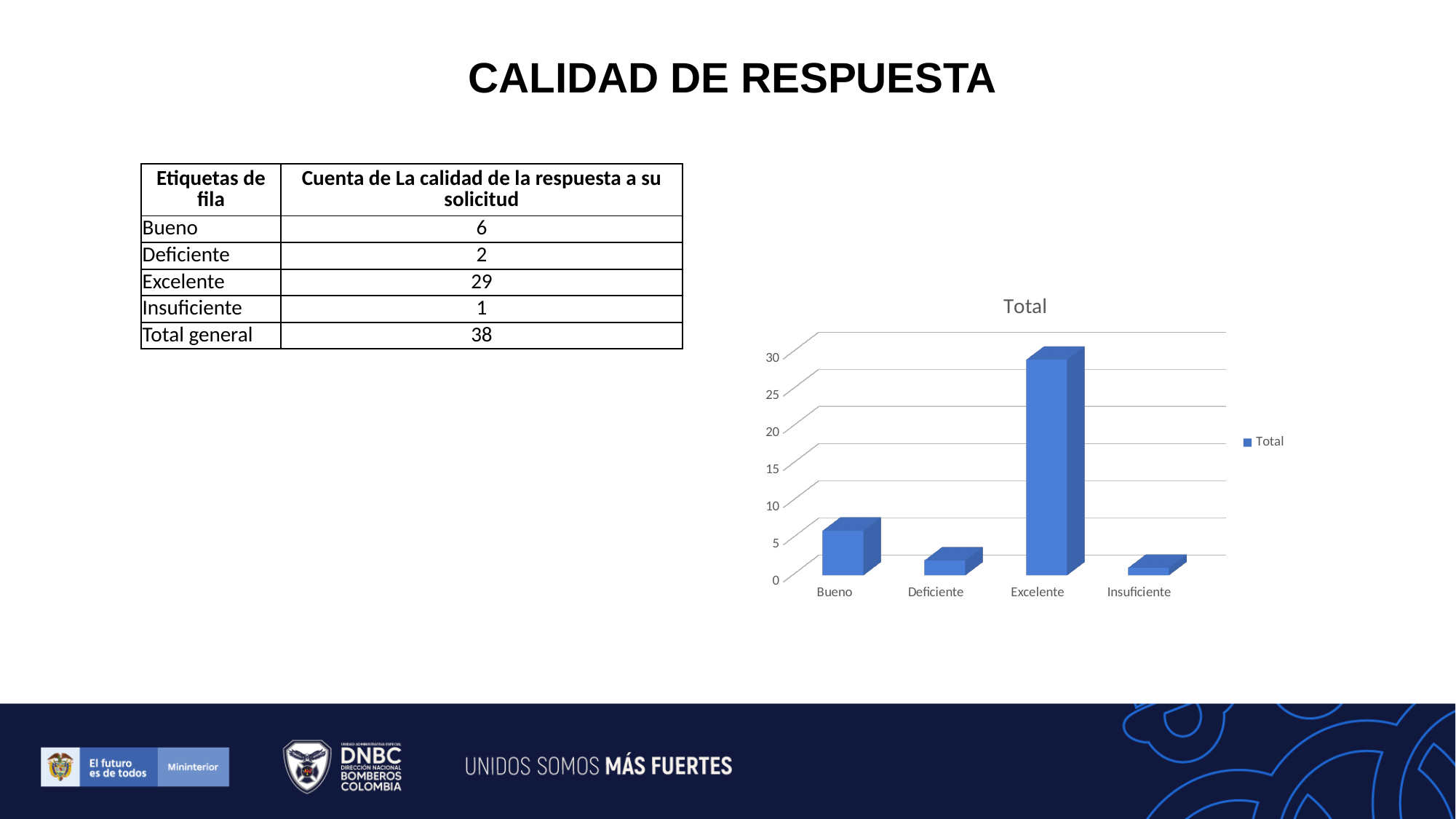
What is the value for Deficiente? 2 What is the title of the chart? Total What type of chart is shown on the slide? bar chart How many series does the chart legend list? 1 What is the value for Excelente? 29 Which is larger, the value for Bueno or the value for Deficiente? Bueno What is the value for Bueno? 6 What is the difference between the values for Excelente and Bueno? 23 Which category has the lowest value in the chart? Insuficiente Is the value for Excelente greater or less than 25? greater How many categories are shown on the x axis of the chart? 4 Which category has the highest value in the chart? Excelente